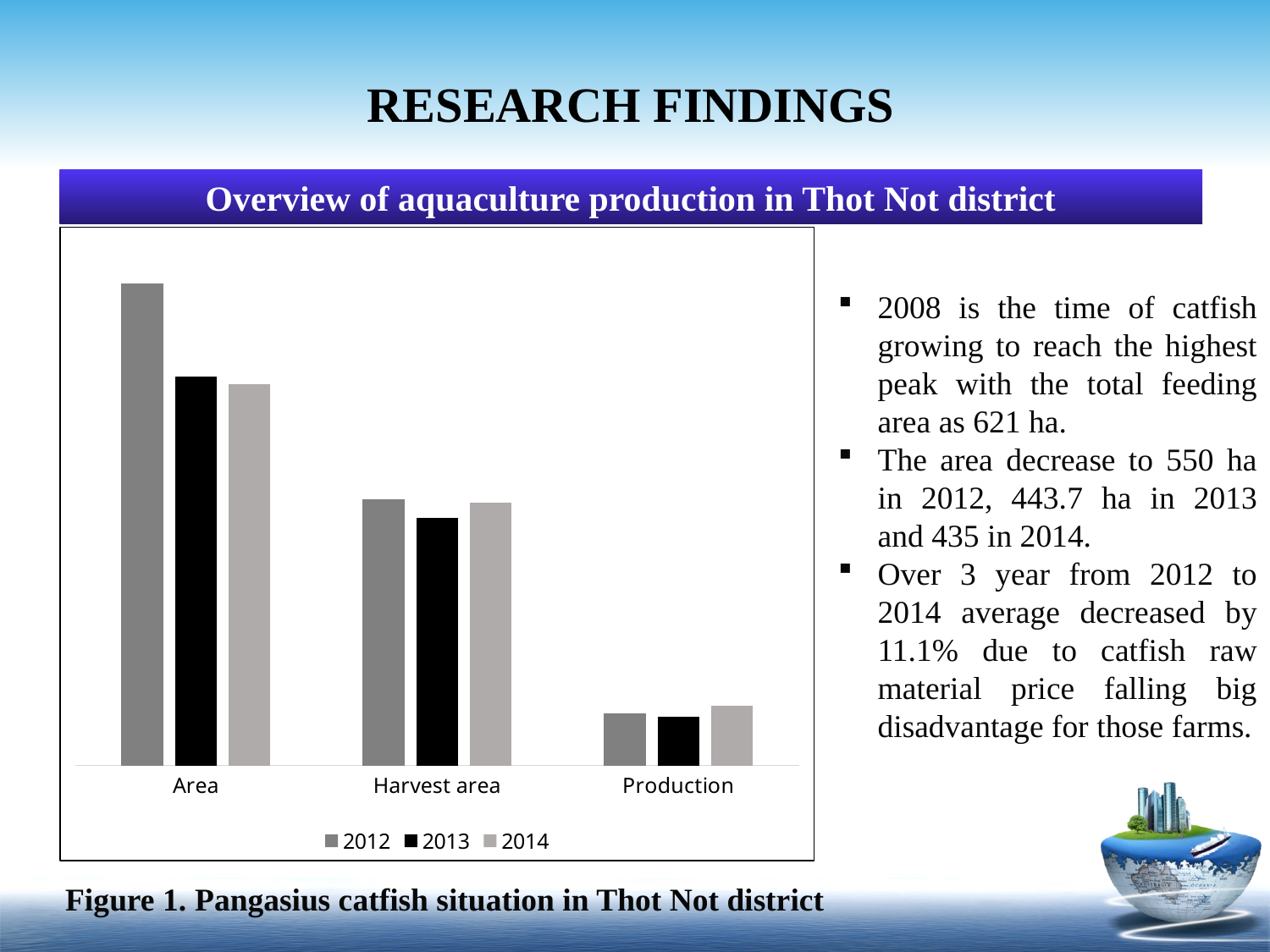
Which years are listed in the chart's legend? 2012, 2013, 2014 What kind of chart is shown on the slide? bar chart For the Area category, which year has the highest bar? 2012 Which category has the shortest bars in the chart? Production Which category has the tallest bars in the chart? Area What is the caption given for the chart below it? Figure 1. Pangasius catfish situation in Thot Not district For the Production category, which year has the highest bar? 2014 How many series does the chart's legend list? 3 How many categories are shown on the x axis of the chart? 3 For the Harvest area category, which year has the lowest bar? 2013 Do the 2012 bars rise or fall moving from Area to Production along the x axis? fall In the Area category, is the 2012 bar or the 2013 bar taller? 2012